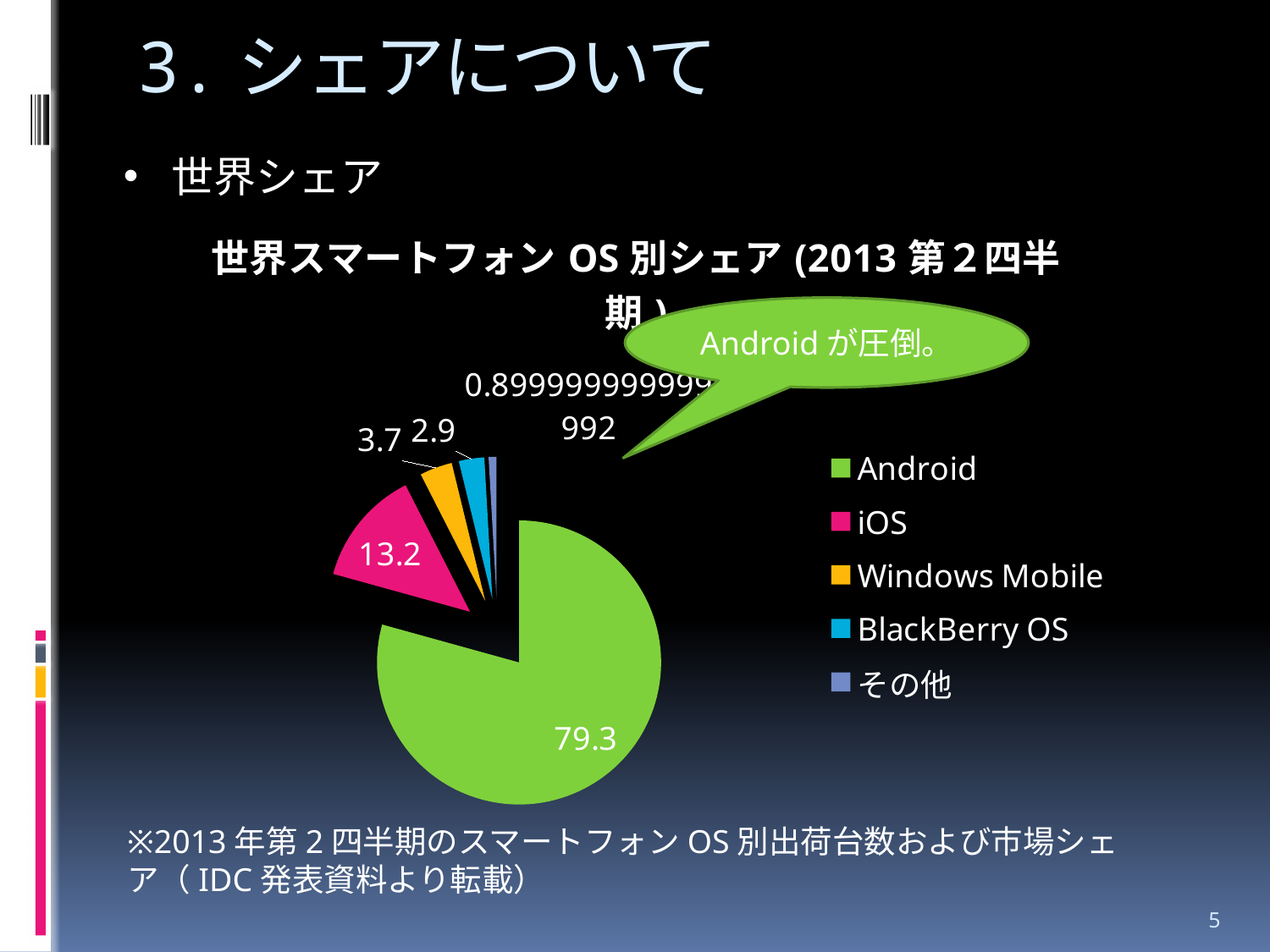
What is the difference between the Android value and the iOS value? 66.1 Which is larger, the value for iOS or the value for Windows Mobile? iOS Which category has the smallest slice in the pie chart? その他 What is the value shown for BlackBerry OS in the pie chart? 2.9 What is the value shown for Android in the pie chart? 79.3 What is the difference between the Windows Mobile value and the BlackBerry OS value? 0.8 What kind of chart is shown on the slide? Pie chart How many categories does the pie chart show? 5 What does the green callout next to the chart say? Android が圧倒。 What is the value shown for iOS in the pie chart? 13.2 What is the value shown for Windows Mobile in the pie chart? 3.7 Which OS has the largest slice in the pie chart? Android